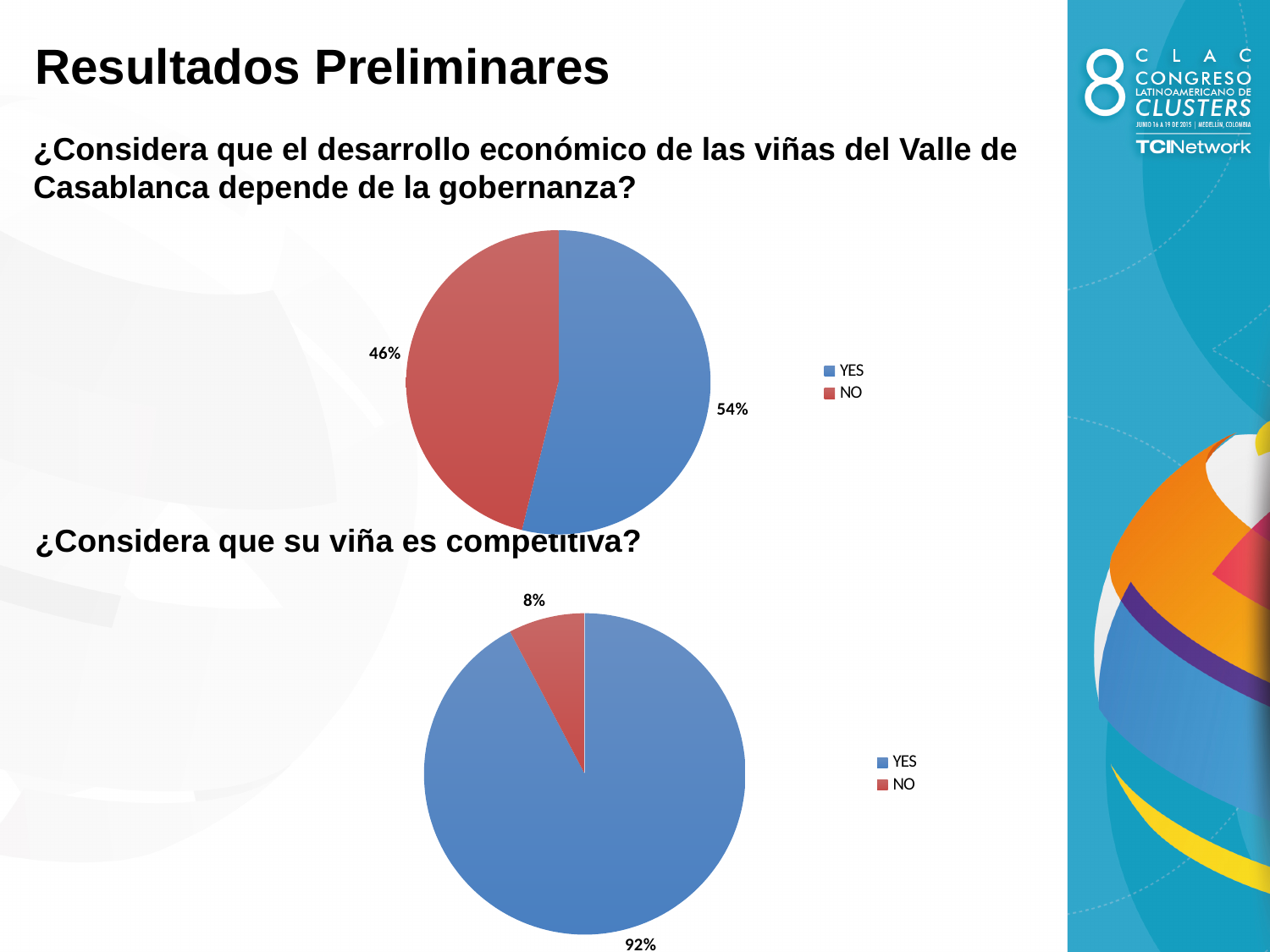
In the top pie chart (about governance), what share of respondents answered YES? 54% In the top pie chart (about governance), what is the difference in percentage points between YES and NO? 8 In the top pie chart, which colour represents NO? red In the bottom pie chart (about competitiveness), what share of respondents answered YES? 92% What type of chart is used on this slide? pie chart In the bottom pie chart (about competitiveness), which answer has the smaller share? NO In the bottom pie chart (about competitiveness), what is the difference in percentage points between YES and NO? 84 Is the YES share larger in the top pie chart or in the bottom pie chart? bottom pie chart How many entries does the legend of the bottom pie chart list? 2 In the bottom pie chart (about competitiveness), what share of respondents answered NO? 8% In the top pie chart (about governance), which answer has the larger share? YES In the top pie chart (about governance), what share of respondents answered NO? 46%